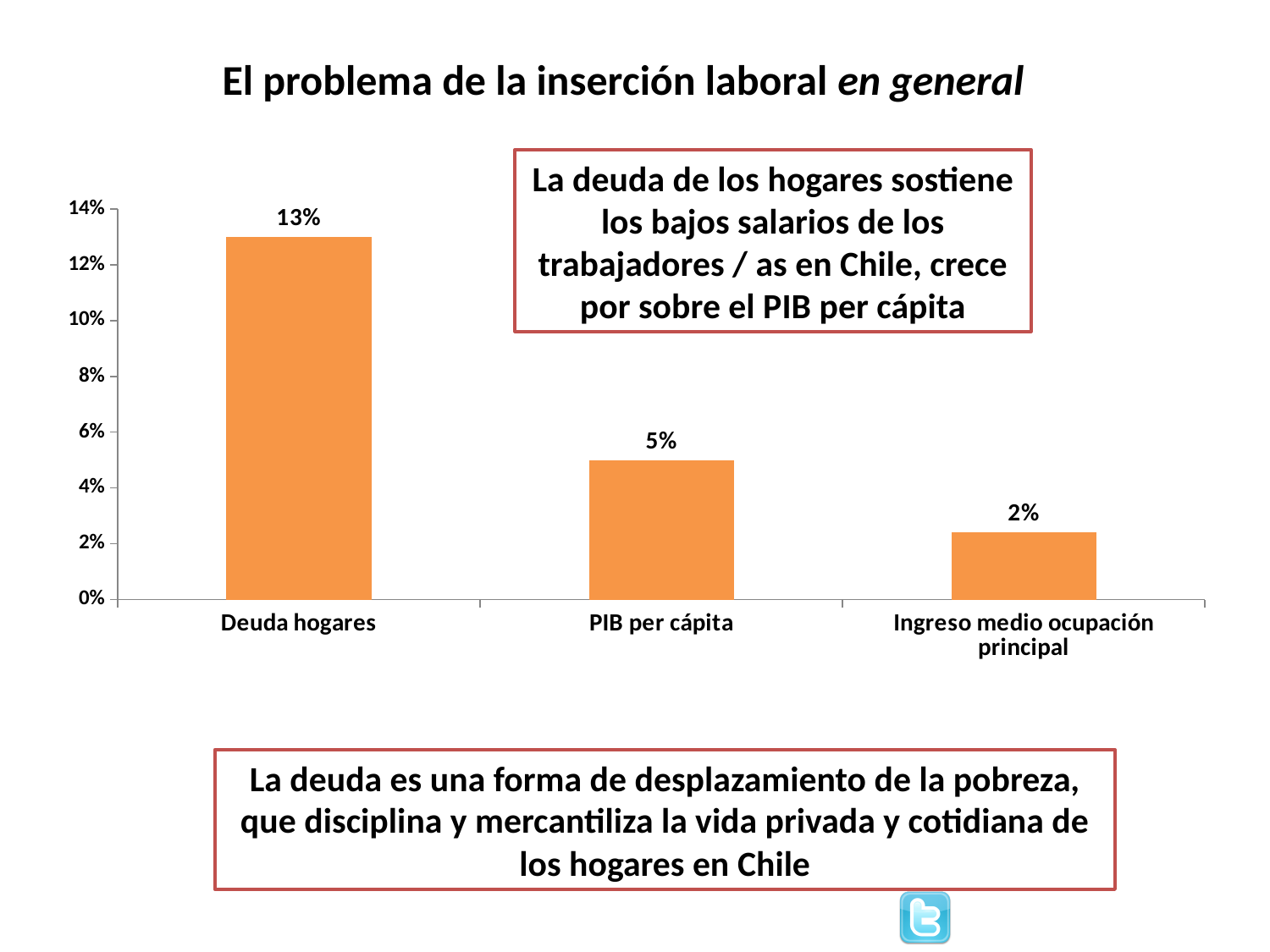
What is the difference between the values for PIB per cápita and Ingreso medio ocupación principal? 3% Do the values rise or fall from left to right across the categories? fall What is the value for Ingreso medio ocupación principal? 2% Is the value for Deuda hogares greater or less than 10%? greater How many categories are shown in the chart? 3 Which is larger, the value for Deuda hogares or the value for PIB per cápita? Deuda hogares Which category has the highest value? Deuda hogares What is the value for Deuda hogares? 13% What kind of chart is shown on the slide? bar chart What is the difference between the values for Deuda hogares and PIB per cápita? 8% What is the value for PIB per cápita? 5% Which category has the lowest value? Ingreso medio ocupación principal